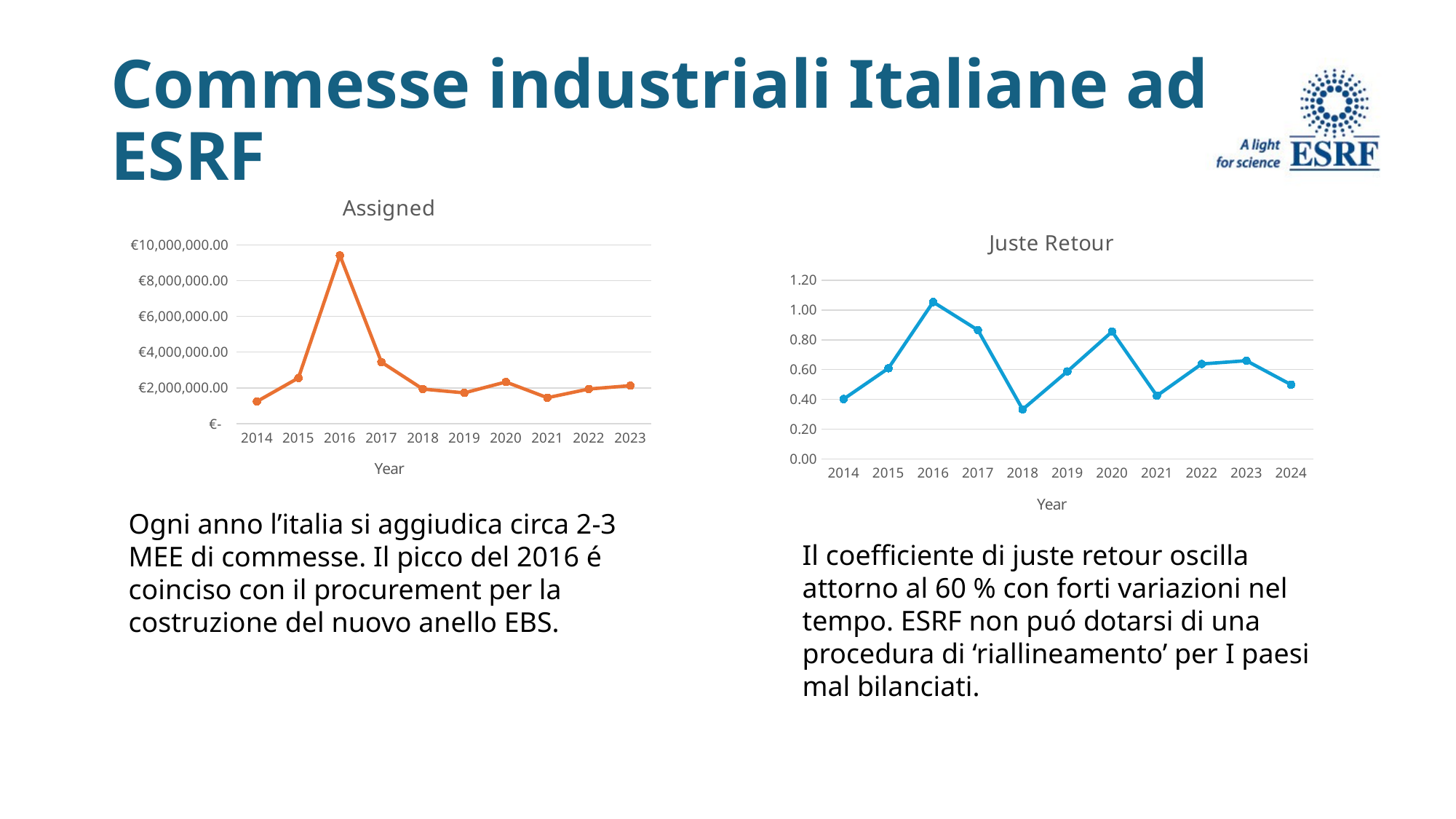
In the "Juste Retour" chart, which year has the lowest value? 2018 How many years are plotted in the "Juste Retour" chart? 11 In the "Juste Retour" chart, which year has the highest value? 2016 How many years are plotted in the "Assigned" chart? 10 In the "Assigned" chart, is the value for 2017 greater or less than €4,000,000.00? less What kind of chart is the "Assigned" chart? line chart In the "Juste Retour" chart, is the value for 2020 greater or less than 0.80? greater In the "Assigned" chart, do the values rise or fall from 2016 to 2018? fall In the "Juste Retour" chart, which is larger, the value for 2017 or the value for 2021? 2017 In the "Assigned" chart, is the value for 2016 greater or less than €8,000,000.00? greater In the "Assigned" chart, which year has the highest value? 2016